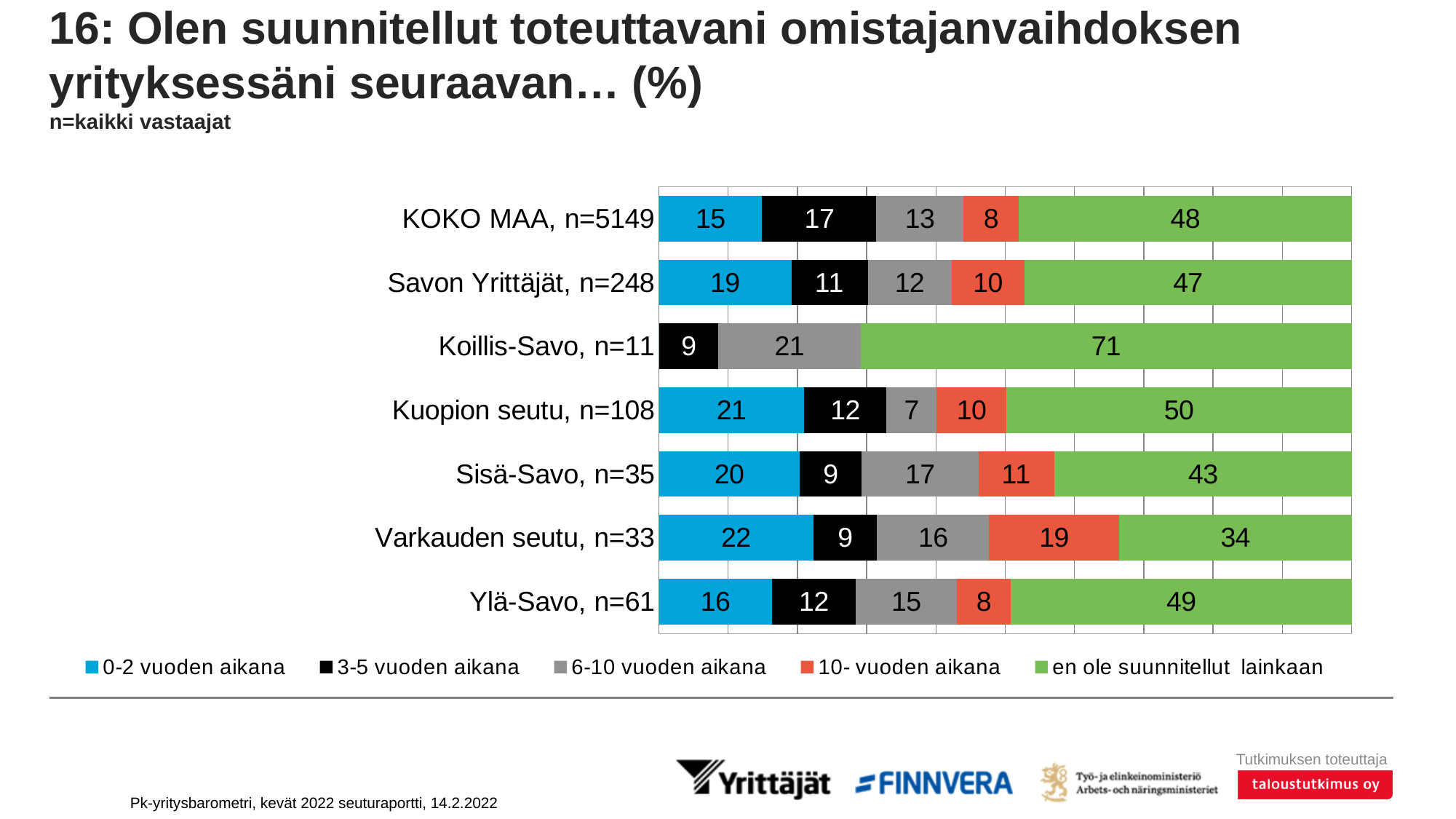
Which has the larger '6-10 vuoden aikana' value, Sisä-Savo, n=35 or Ylä-Savo, n=61? Sisä-Savo, n=35 What is the value for '10- vuoden aikana' for Varkauden seutu, n=33? 19 Which category has the highest value for 'en ole suunnitellut lainkaan'? Koillis-Savo, n=11 What is the value for '6-10 vuoden aikana' for Koillis-Savo, n=11? 21 Which category has the lowest value for 'en ole suunnitellut lainkaan'? Varkauden seutu, n=33 How many series does the legend list? 5 Which category has the highest value for '0-2 vuoden aikana'? Varkauden seutu, n=33 What is the total of the stacked bar for Varkauden seutu, n=33? 100 How many categories are shown on the chart? 7 What is the difference between the '3-5 vuoden aikana' values for KOKO MAA, n=5149 and Savon Yrittäjät, n=248? 6 What is the value for '0-2 vuoden aikana' for Kuopion seutu, n=108? 21 What kind of chart is shown on the slide? Stacked bar chart